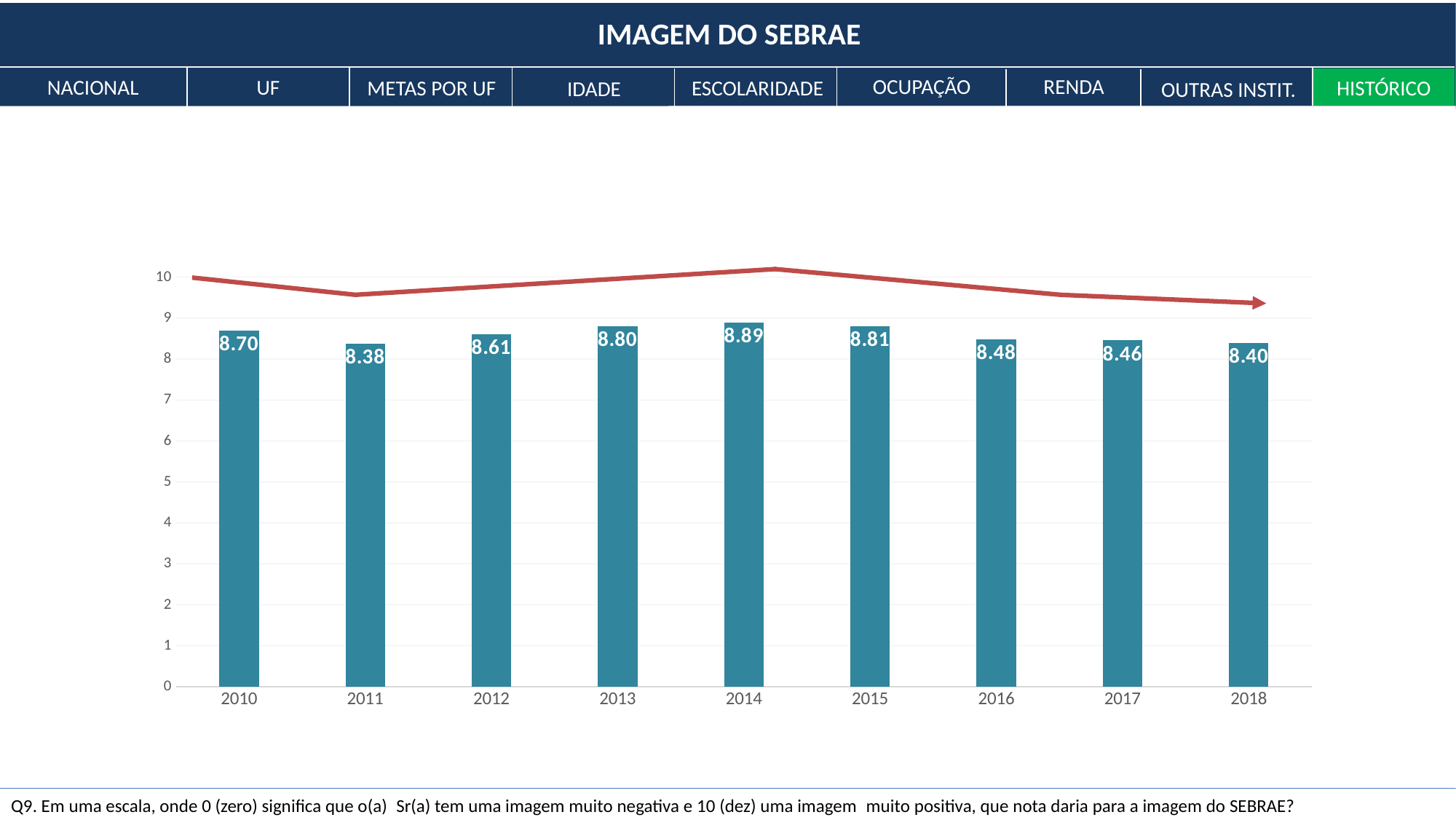
What is the title shown at the top of the slide? IMAGEM DO SEBRAE Which year has the highest value? 2014 What is the value for 2011? 8.38 How many years are shown on the x axis? 9 What kind of chart is this? bar chart What is the difference between the values for 2014 and 2011? 0.51 What is the value for 2018? 8.40 Do the values rise or fall from 2015 to 2018? fall Which year has the lowest value? 2011 Which is larger, the value for 2010 or the value for 2016? 2010 What is the value for 2014? 8.89 Is the value for 2013 greater or less than 9? less